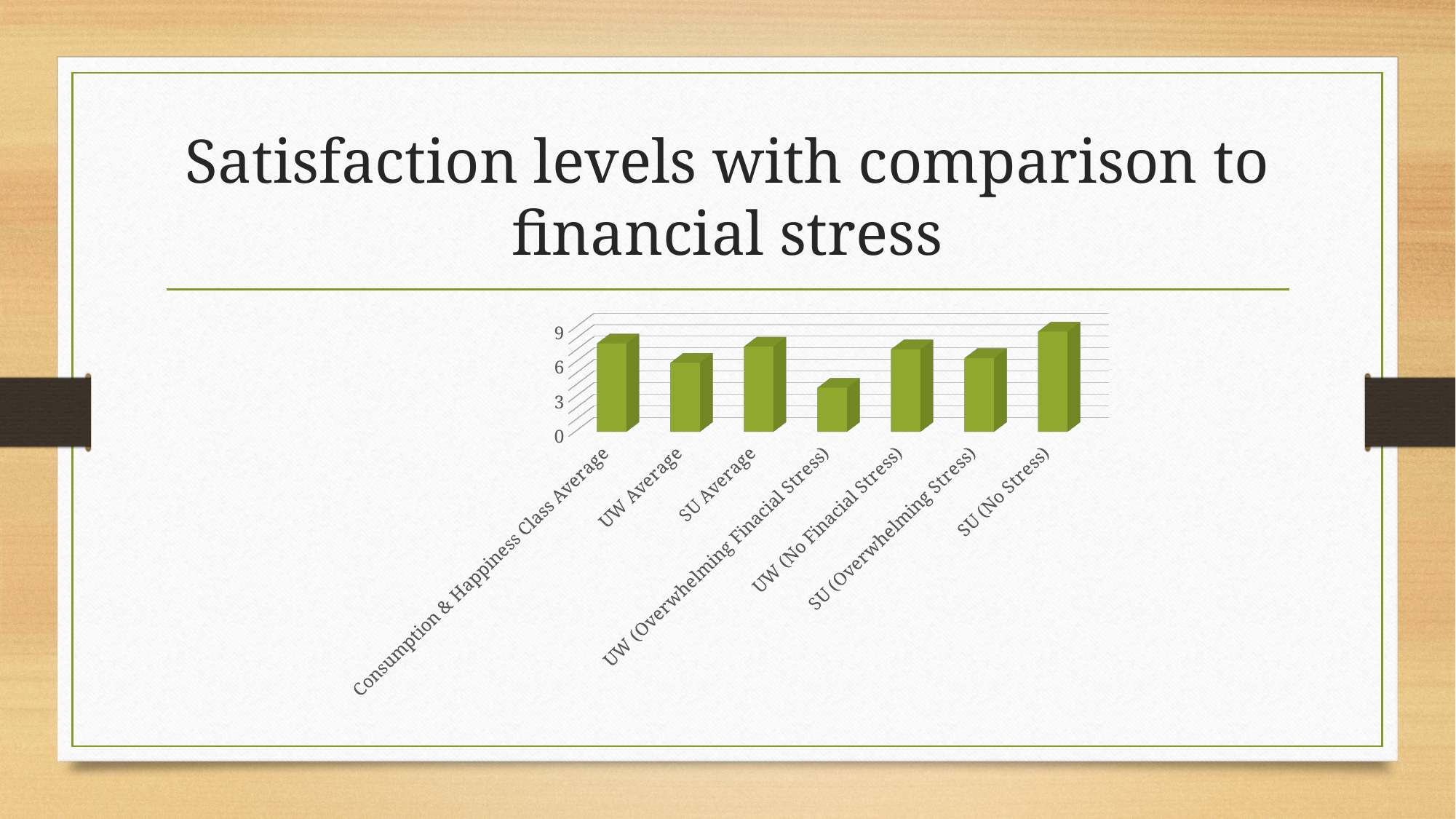
Which is larger, the value for SU (No Stress) or the value for UW (Overwhelming Finacial Stress)? SU (No Stress) Which is larger, the value for UW (No Finacial Stress) or the value for UW (Overwhelming Finacial Stress)? UW (No Finacial Stress) Is the value for UW (Overwhelming Finacial Stress) greater or less than 6? less Is the value for Consumption & Happiness Class Average greater or less than 6? greater Is the value for UW Average greater or less than 3? greater Which category has the highest value in the chart? SU (No Stress) Which is larger, the value for Consumption & Happiness Class Average or the value for UW Average? Consumption & Happiness Class Average What is the title of the slide containing the chart? Satisfaction levels with comparison to financial stress What kind of chart is shown on the slide? bar chart Which category has the lowest value in the chart? UW (Overwhelming Finacial Stress) How many categories are plotted in the chart? 7